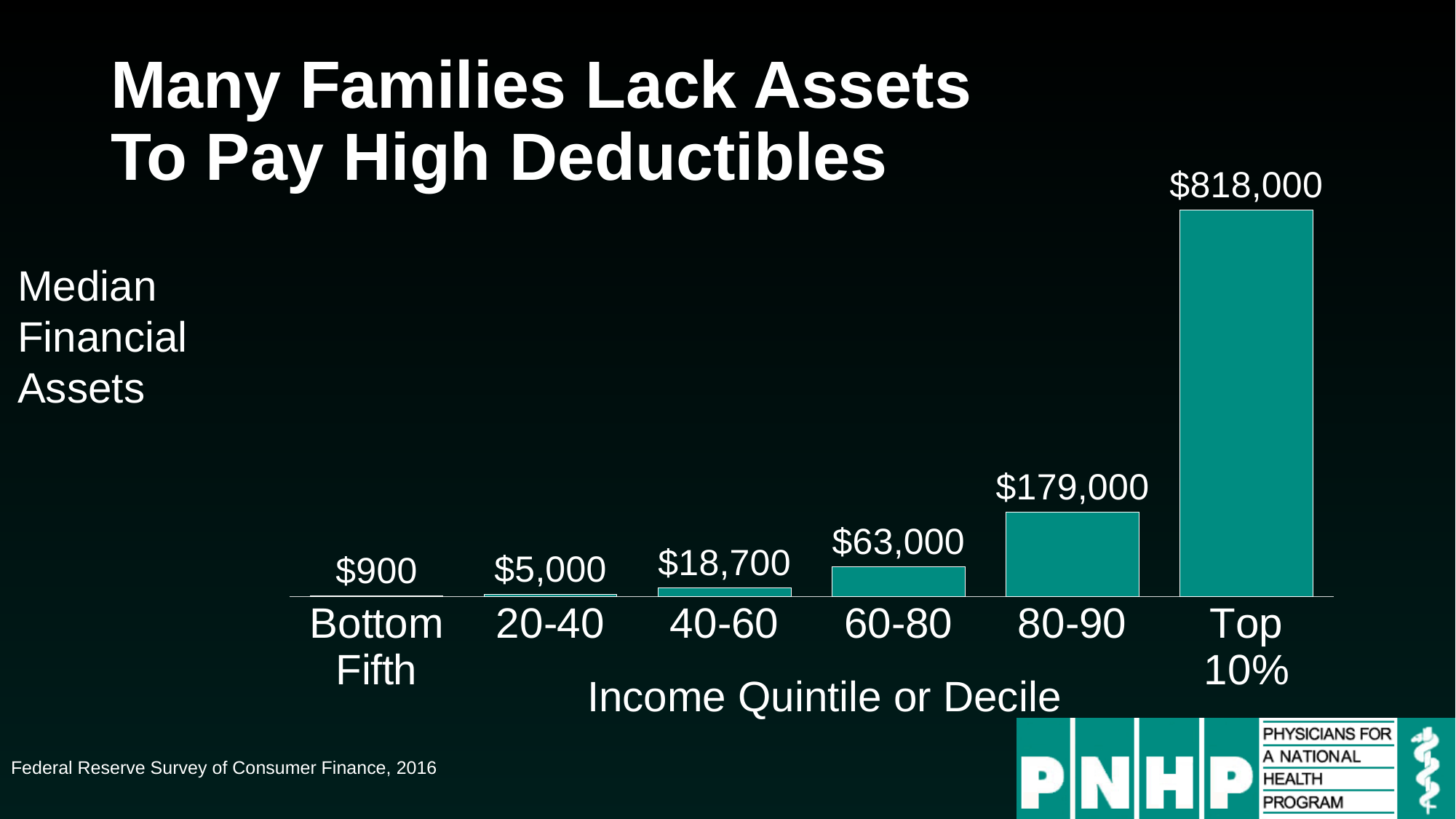
Which income group has the lowest median financial assets? Bottom Fifth Which has higher median financial assets, the 20-40 group or the 60-80 group? 60-80 What is the median financial assets value for the 80-90 income decile? $179,000 Do median financial assets rise or fall as income group increases along the x axis? Rise What kind of chart is shown on the slide? Bar chart What is the median financial assets value for the 40-60 income quintile? $18,700 What is the x-axis label of the chart? Income Quintile or Decile What is the difference in median financial assets between the Top 10% and the 80-90 group? $639,000 What is the difference in median financial assets between the 60-80 and 40-60 groups? $44,300 How many income groups are shown on the chart? 6 Which income group has the highest median financial assets? Top 10% What is the median financial assets value for the Bottom Fifth income group? $900